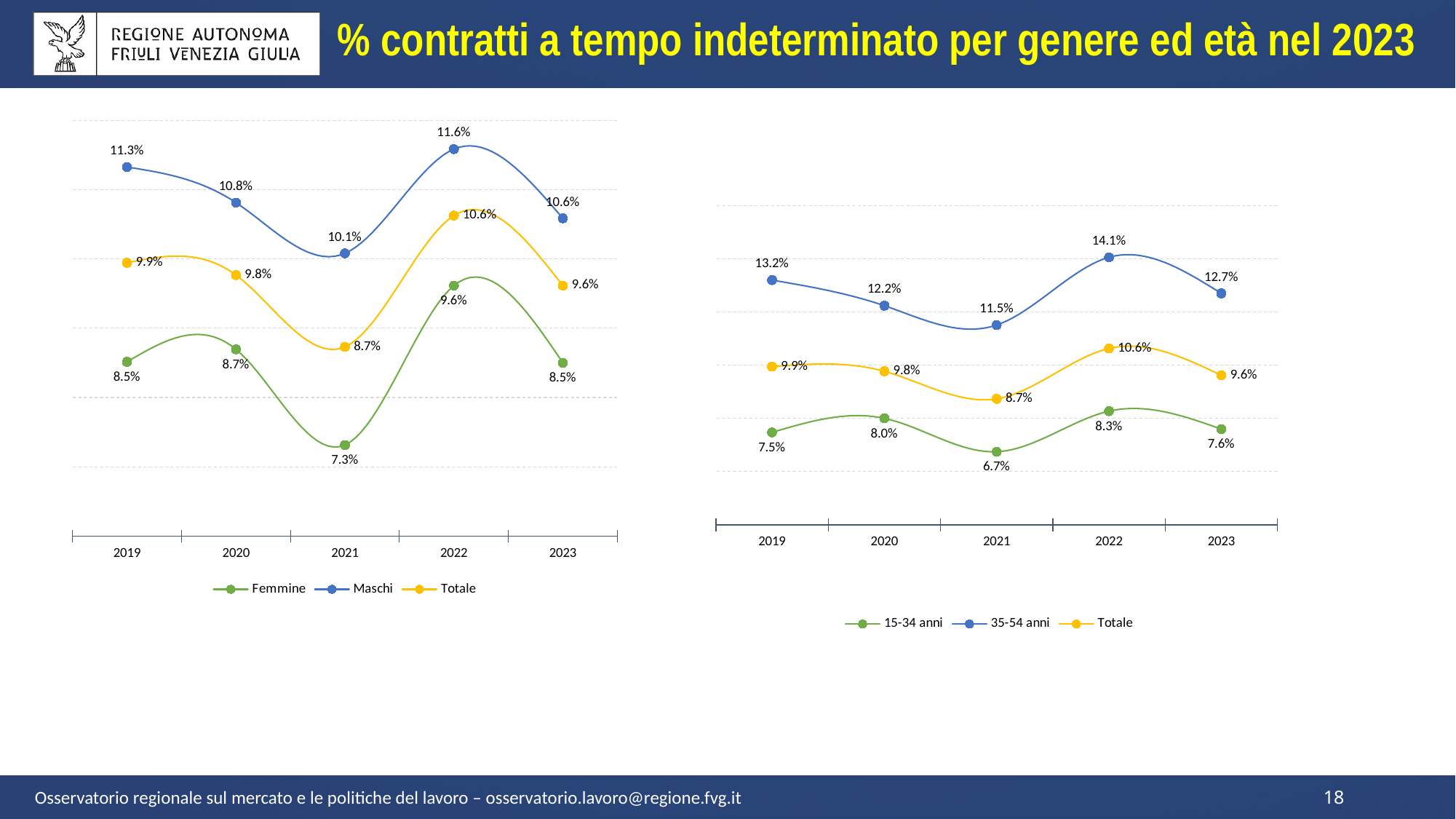
In the left chart, in which year is the value for Maschi highest? 2022 In the left chart, does the Totale series rise or fall from 2022 to 2023? Fall What kind of chart is the left chart? Line chart In the left chart, what is the difference between Maschi and Femmine in 2023? 2.1% In the left chart, what is the value for Maschi in 2022? 11.6% In the right chart, in which year is the value for 15-34 anni lowest? 2021 In the right chart, what is the value for 35-54 anni in 2019? 13.2% In the right chart, which is larger in 2020: 35-54 anni or Totale? 35-54 anni In the right chart, what is the difference between 35-54 anni and 15-34 anni in 2022? 5.8% How many years are shown on the x axis of the left chart? 5 How many series does the legend of the right chart list? 3 In the left chart, what is the value for Femmine in 2021? 7.3%